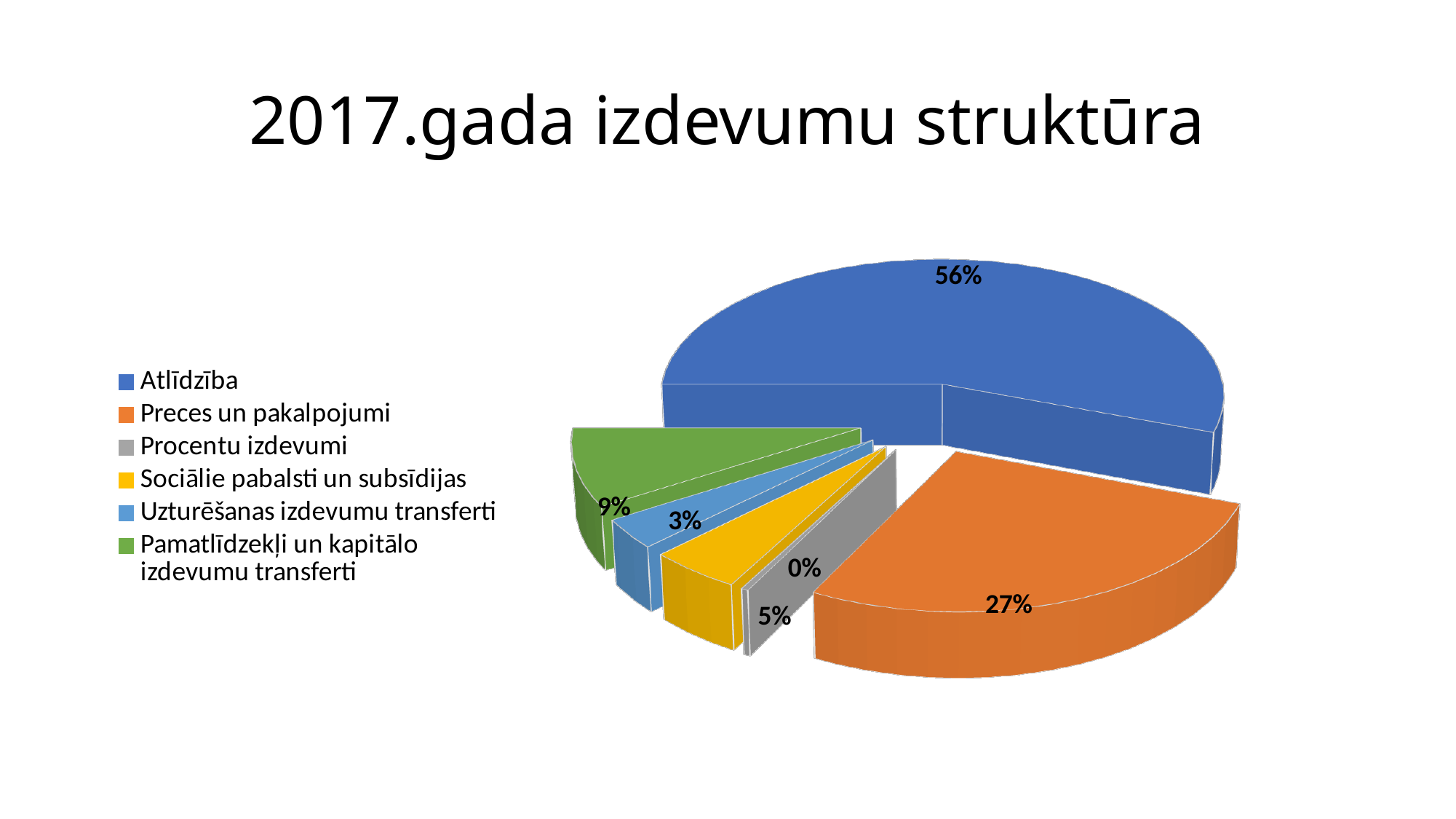
What share of the pie does Preces un pakalpojumi take? 27% What kind of chart is shown on the slide? pie chart What share of the pie does Procentu izdevumi take? 0% What share of the pie does Atlīdzība take? 56% What is the difference in percentage points between Atlīdzība and Preces un pakalpojumi? 29 Which category has the smallest share of the pie? Procentu izdevumi What is the title of the chart? 2017.gada izdevumu struktūra How many categories does the legend list? 6 Which category has the largest share of the pie? Atlīdzība